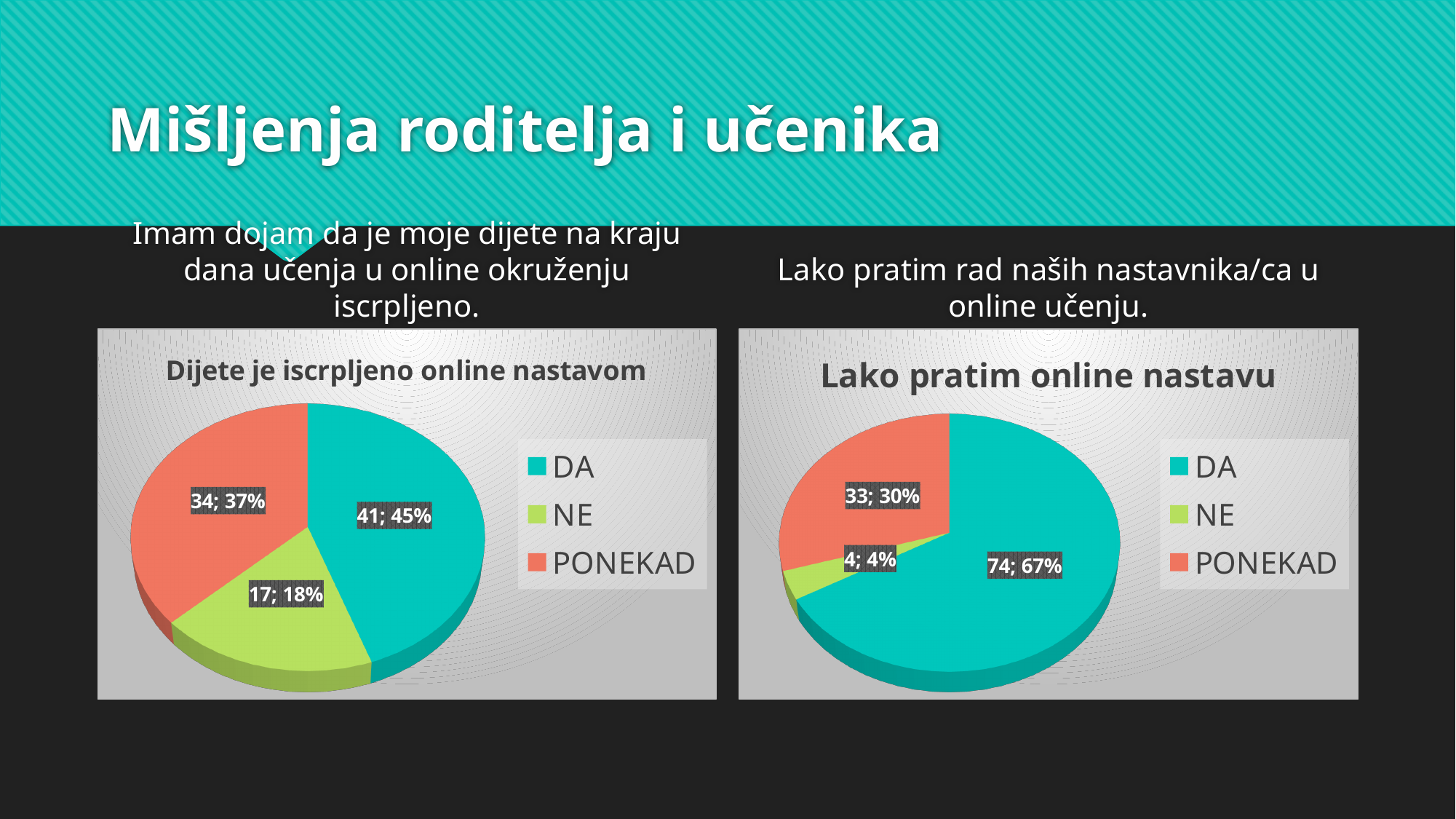
In the chart titled "Lako pratim online nastavu", what is the count for DA? 74 In the chart titled "Dijete je iscrpljeno online nastavom", what is the difference between the DA count and the NE count? 24 In the chart titled "Lako pratim online nastavu", which category has the largest slice? DA In the chart titled "Dijete je iscrpljeno online nastavom", what is the count for DA? 41 How many categories does the legend of the chart titled "Lako pratim online nastavu" list? 3 In the chart titled "Dijete je iscrpljeno online nastavom", which category has the smallest slice? NE What type of chart is the chart titled "Dijete je iscrpljeno online nastavom"? Pie chart In the chart titled "Lako pratim online nastavu", which is larger, the count for PONEKAD or the count for NE? PONEKAD In the chart titled "Lako pratim online nastavu", what percentage share does NE have? 4% In the chart titled "Dijete je iscrpljeno online nastavom", what percentage share does PONEKAD have? 37% In the chart titled "Lako pratim online nastavu", what is the difference between the DA count and the PONEKAD count? 41 In the chart titled "Dijete je iscrpljeno online nastavom", what colour is the PONEKAD slice? Red/orange